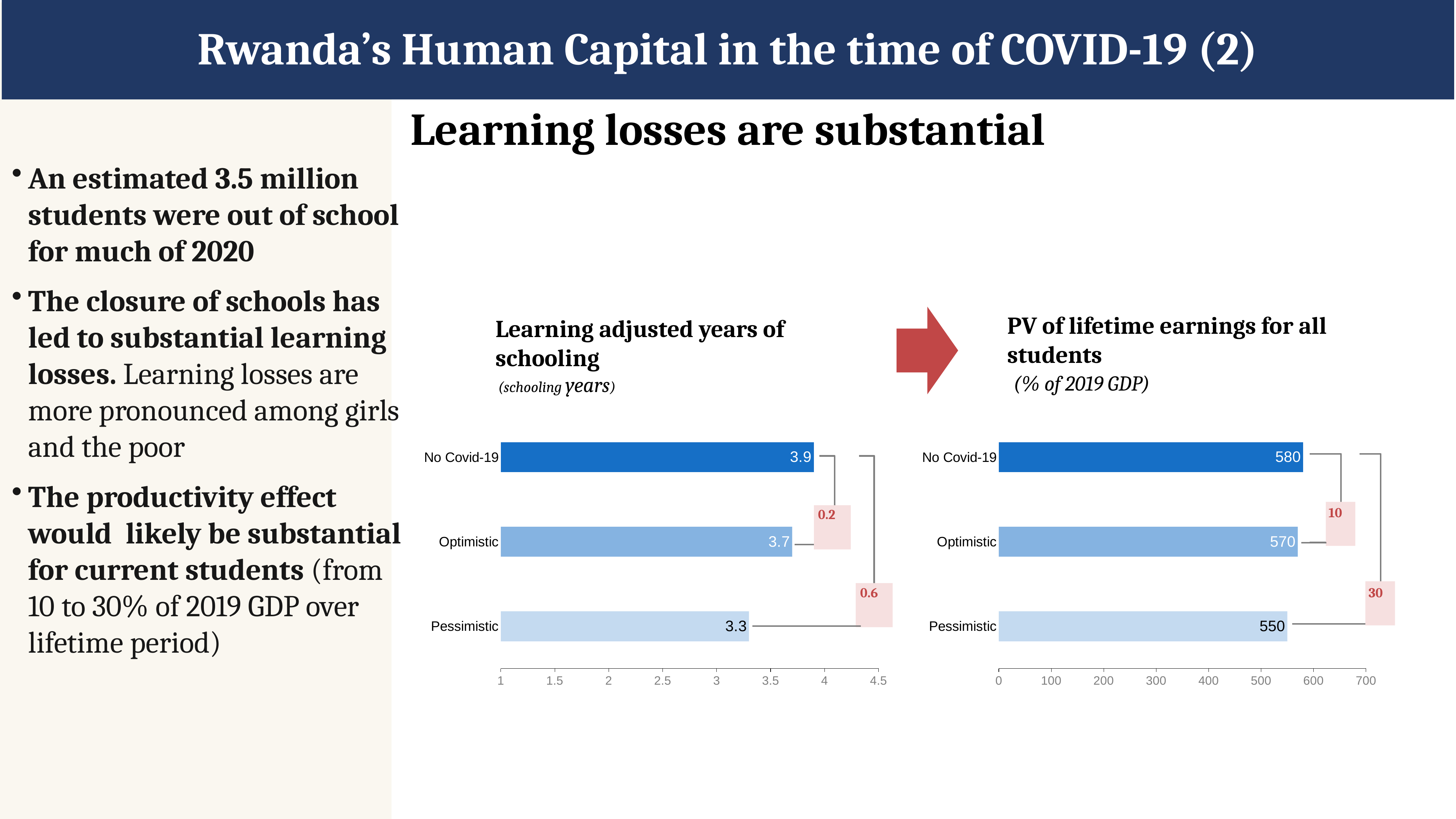
In the 'Learning adjusted years of schooling' chart, what is the value for Pessimistic? 3.3 In the 'PV of lifetime earnings for all students' chart, what is the difference between No Covid-19 and Pessimistic? 30 In the 'PV of lifetime earnings for all students' chart, what unit is given in the subtitle? % of 2019 GDP In the 'PV of lifetime earnings for all students' chart, what is the value for Pessimistic? 550 In the 'PV of lifetime earnings for all students' chart, which category has the highest value? No Covid-19 In the 'Learning adjusted years of schooling' chart, how many categories are shown? 3 In the 'PV of lifetime earnings for all students' chart, what is the value for Optimistic? 570 In the 'Learning adjusted years of schooling' chart, which category has the lowest value? Pessimistic In the 'PV of lifetime earnings for all students' chart, which is larger, Optimistic or Pessimistic? Optimistic In the 'Learning adjusted years of schooling' chart, what is the difference between No Covid-19 and Optimistic? 0.2 In the 'Learning adjusted years of schooling' chart, what is the value for No Covid-19? 3.9 What kind of chart is the 'PV of lifetime earnings for all students' chart? Bar chart